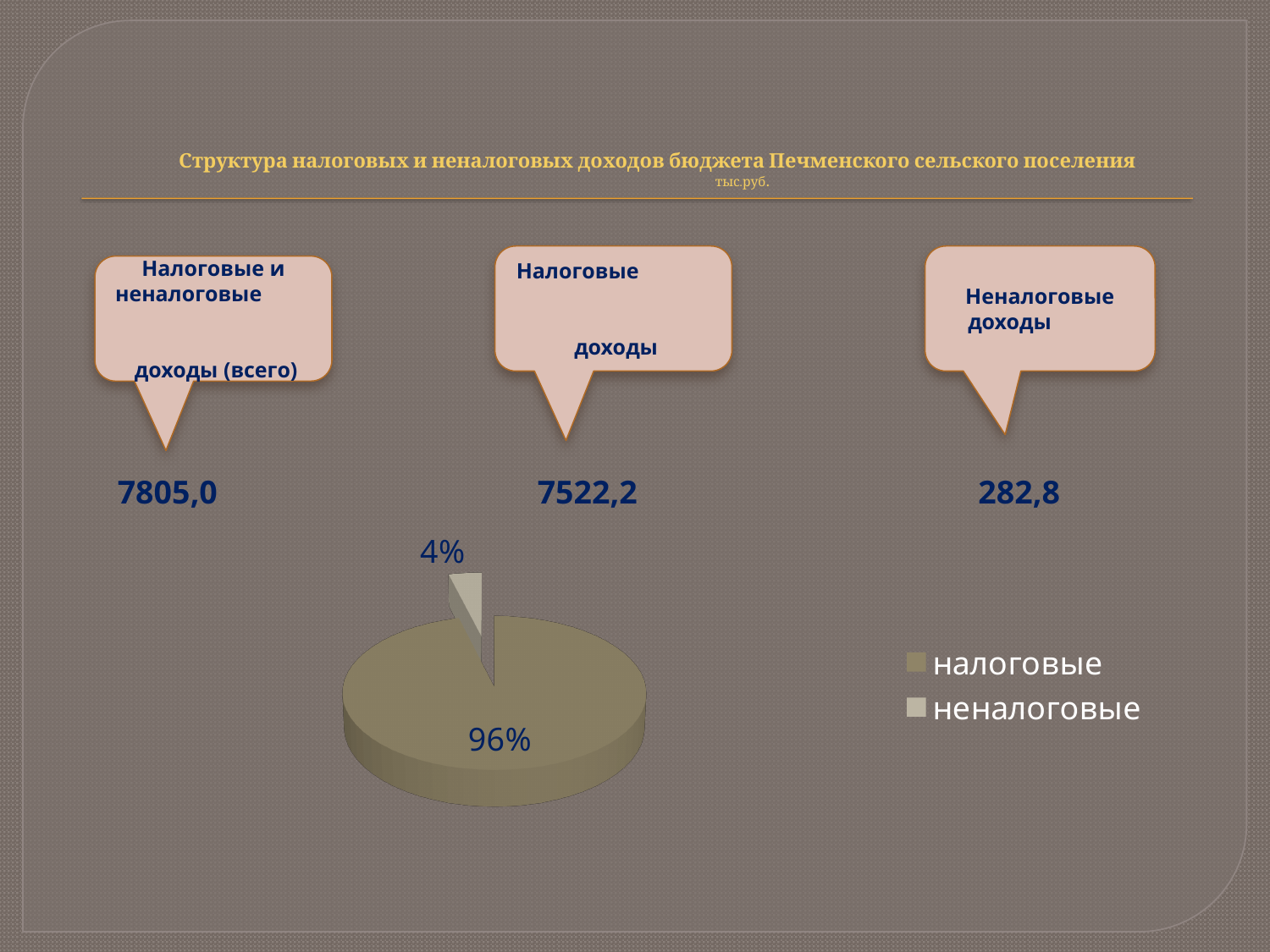
Which slice of the pie chart is the largest? налоговые What kind of chart is shown on the slide? pie chart How many slices does the pie chart have? 2 What are the two entries listed in the pie chart's legend? налоговые, неналоговые How many entries does the legend of the pie chart list? 2 By how many percentage points does the налоговые share exceed the неналоговые share? 92 What share of the pie does the неналоговые slice represent? 4% What share of the pie does the налоговые slice represent? 96% Is the share of the неналоговые slice greater or less than 10%? less What is the total of the two percentage labels shown on the pie chart? 100% Which is larger in the pie chart, the налоговые slice or the неналоговые slice? налоговые Which slice of the pie chart is the smallest? неналоговые